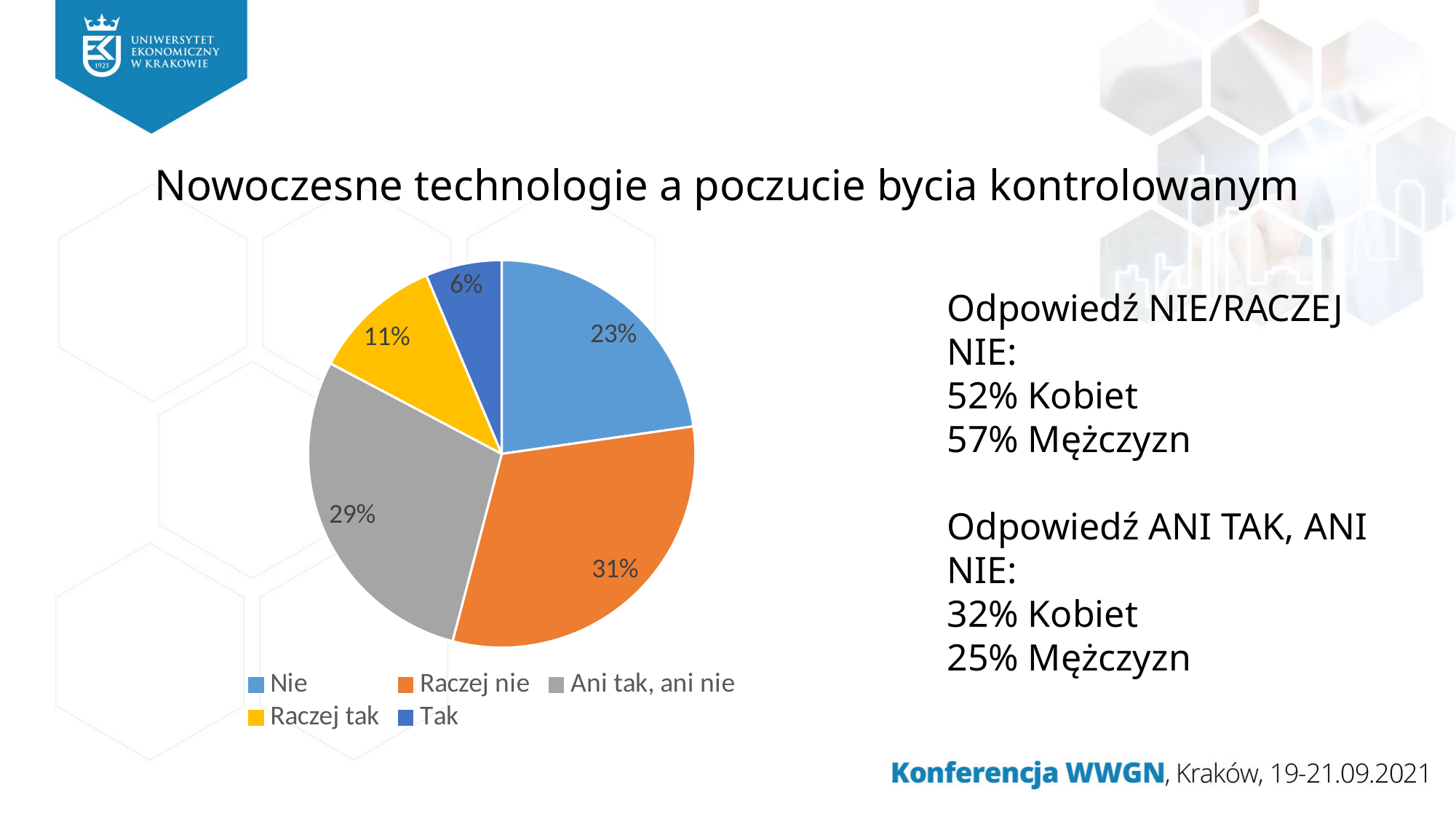
What percentage of the pie is the 'Raczej nie' slice? 31% Which category has the largest slice of the pie? Raczej nie What is the combined share of the 'Nie' and 'Raczej nie' slices? 54% What type of chart is shown on the slide? pie chart How many categories does the pie chart have? 5 What percentage of the pie is the 'Nie' slice? 23% What is the difference in percentage points between the 'Raczej nie' and 'Nie' slices? 8 What percentage of the pie is the 'Ani tak, ani nie' slice? 29% Which category has the smallest slice of the pie? Tak Which slice is larger, 'Raczej tak' or 'Tak'? Raczej tak What percentage of the pie is the 'Tak' slice? 6% What colour is the 'Ani tak, ani nie' slice? grey